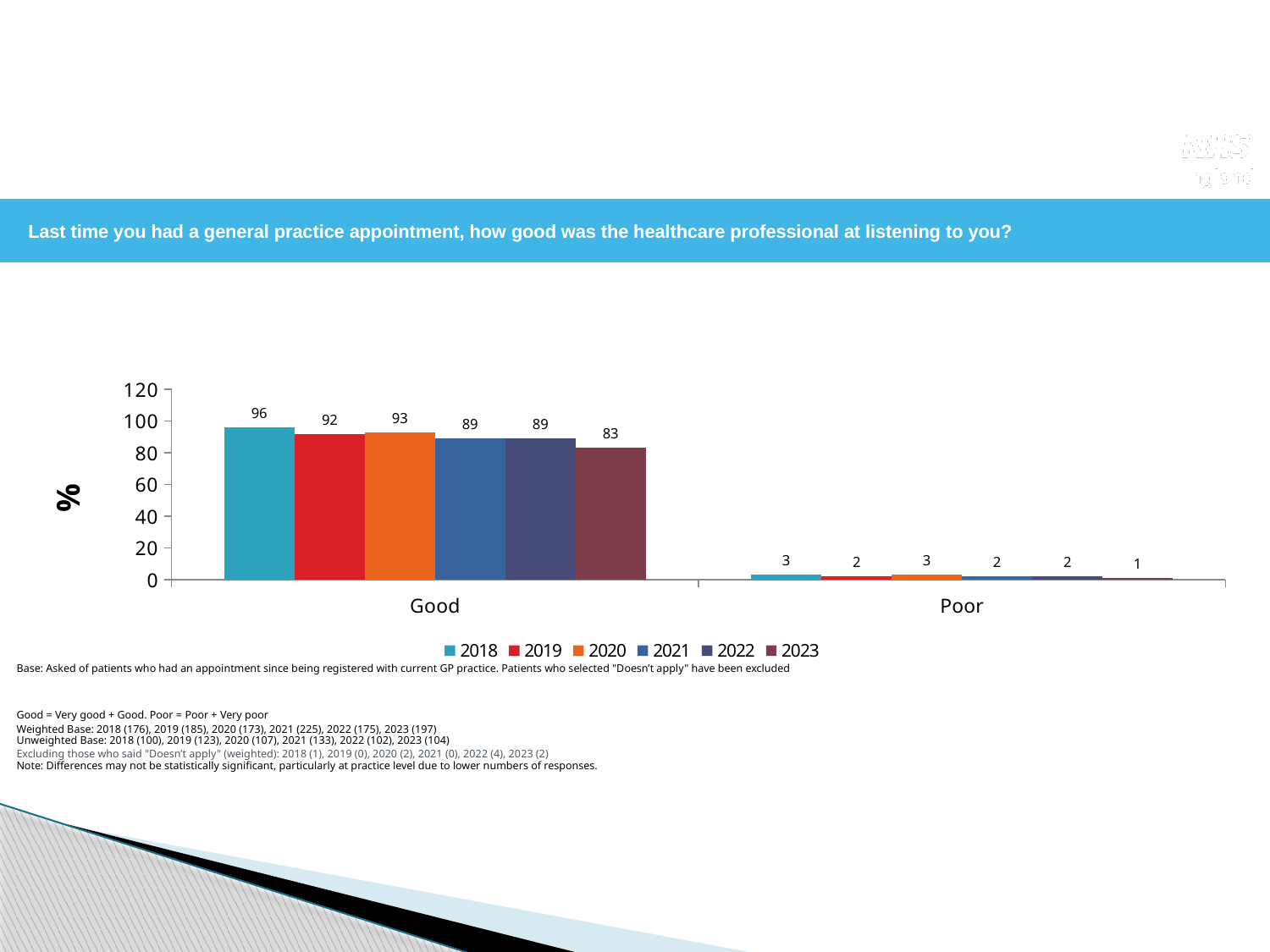
What is the value for 2018 in the Good category? 96 What is the value for 2020 in the Poor category? 3 Is the value for 2023 in the Good category greater or less than 80? greater What is the value for 2023 in the Good category? 83 Which year has the lowest value in the Good category? 2023 What is the label on the vertical axis? % What kind of chart is shown on the slide? Bar chart How many series does the legend list? 6 What is the difference between the 2018 and 2023 values in the Good category? 13 Which year has the highest value in the Good category? 2018 How many categories are shown on the x axis? 2 Which is larger in the Good category, the value for 2019 or the value for 2020? 2020